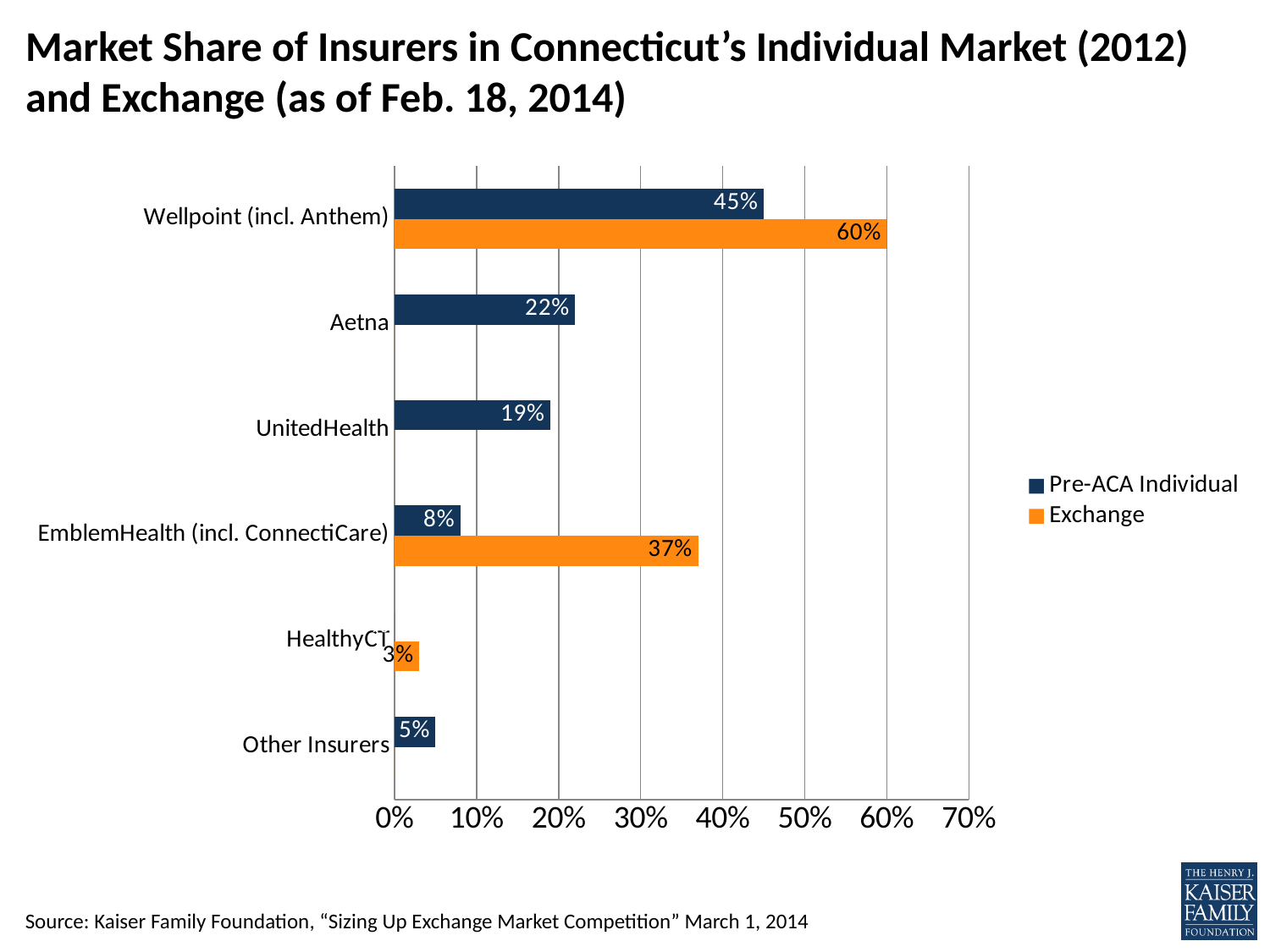
Which is larger: UnitedHealth's Pre-ACA Individual share or Aetna's Pre-ACA Individual share? Aetna's Pre-ACA Individual share What is the Exchange market share for EmblemHealth (incl. ConnectiCare)? 37% What is the Exchange market share for HealthyCT? 3% What is the Pre-ACA Individual market share for Aetna? 22% Which colour represents the Exchange series in the chart? Orange What is the Pre-ACA Individual market share for Wellpoint (incl. Anthem)? 45% What is the difference between Wellpoint's Exchange share and its Pre-ACA Individual share? 15% How many series does the legend list? 2 What kind of chart is shown on the slide? Bar chart Which insurer has the highest Exchange market share? Wellpoint (incl. Anthem) How many insurer categories are shown on the chart? 6